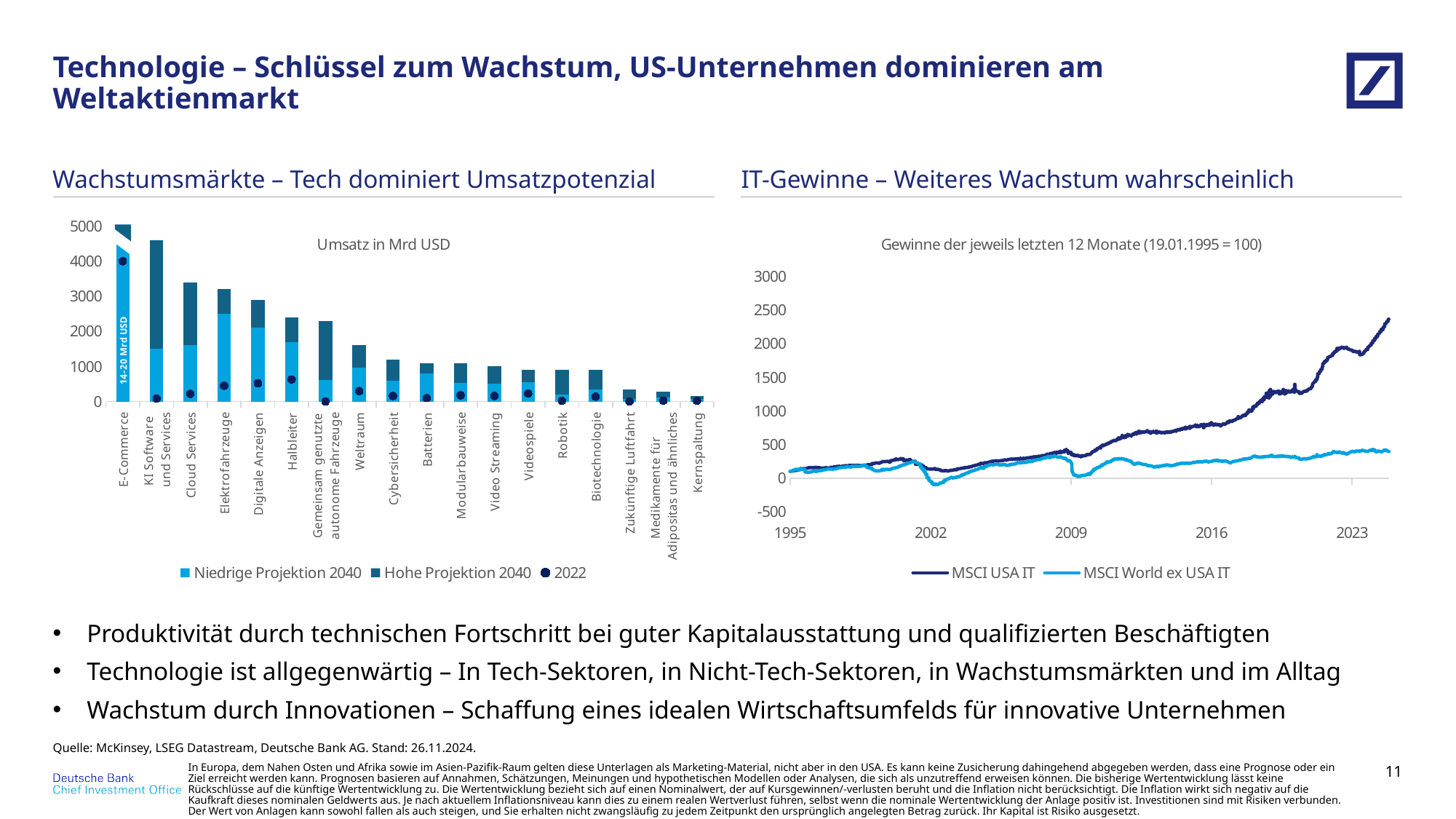
On the left chart, which category has the lowest bar? Kernspaltung On the right chart, how many series does the legend list? 2 On the right chart, at the end of the series (after 2023), is the value for MSCI USA IT greater or less than 2000? greater On the left chart, which stacked bar is taller: Halbleiter or Weltraum? Halbleiter On the left chart, which category has the highest bar? E-Commerce On the left chart, how many categories are shown on the x axis? 18 On the right chart, what is the subtitle printed above the plot area? Gewinne der jeweils letzten 12 Monate (19.01.1995 = 100) On the right chart 'IT-Gewinne – Weiteres Wachstum wahrscheinlich', what kind of chart is used? Line chart On the right chart, does the MSCI USA IT line generally rise or fall from 1995 to 2023? rise On the left chart, how many entries does the legend list? 3 On the left chart, is the top of the stacked bar for KI Software und Services greater or less than 4000? greater On the left chart 'Wachstumsmärkte – Tech dominiert Umsatzpotenzial', what kind of chart is used? Bar chart